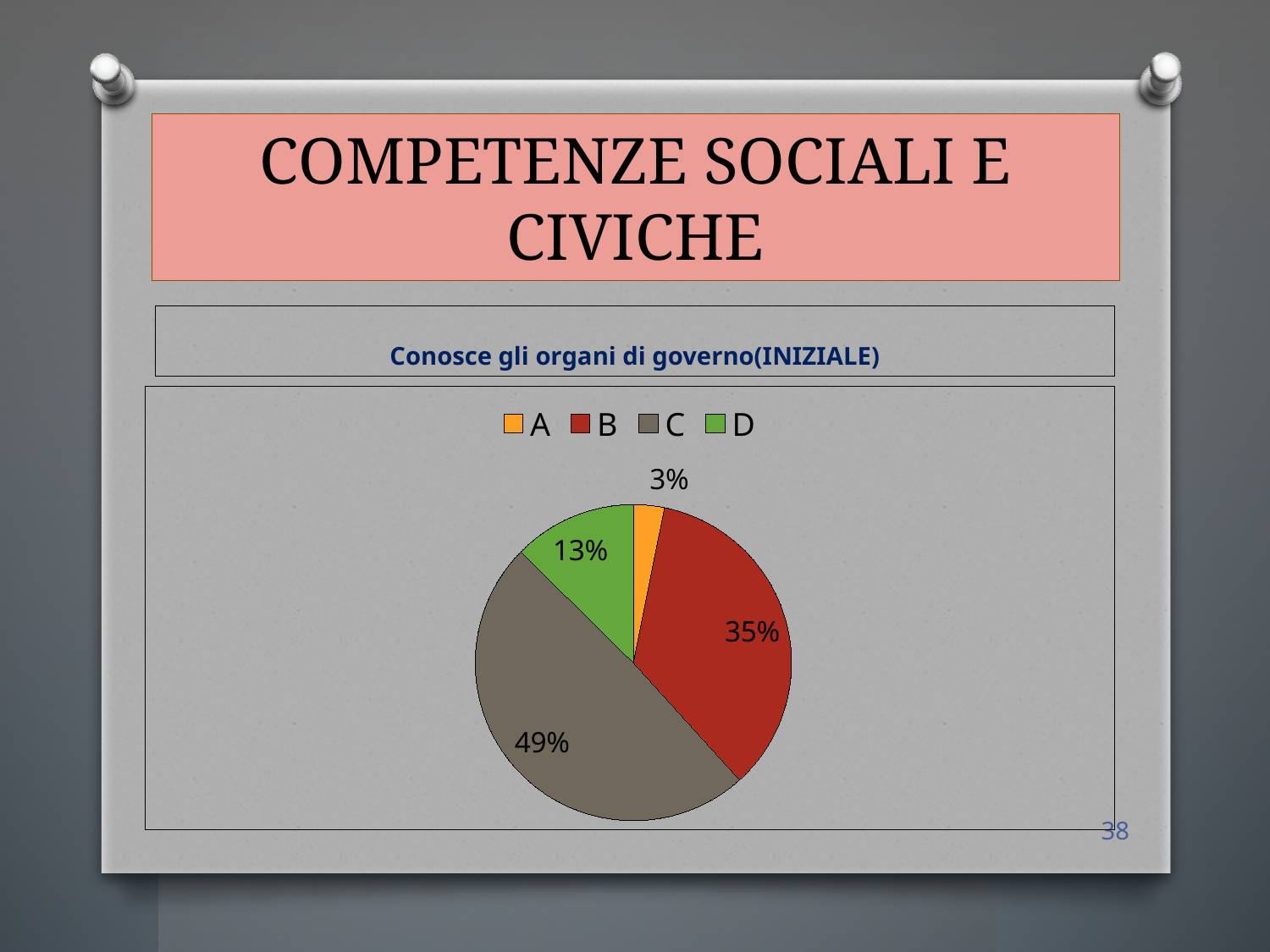
What kind of chart is shown on the slide? pie chart Which is larger, the value for B or the value for D? B How many categories does the legend list? 4 What is the value for category B? 35% What is the value for category C? 49% What is the value for category A? 3% Which category has the largest slice? C What colour is the slice for category D? green What is the difference between the values for C and B? 14% What is the value for category D? 13% Which category has the smallest slice? A What is the title of the chart? Conosce gli organi di governo(INIZIALE)